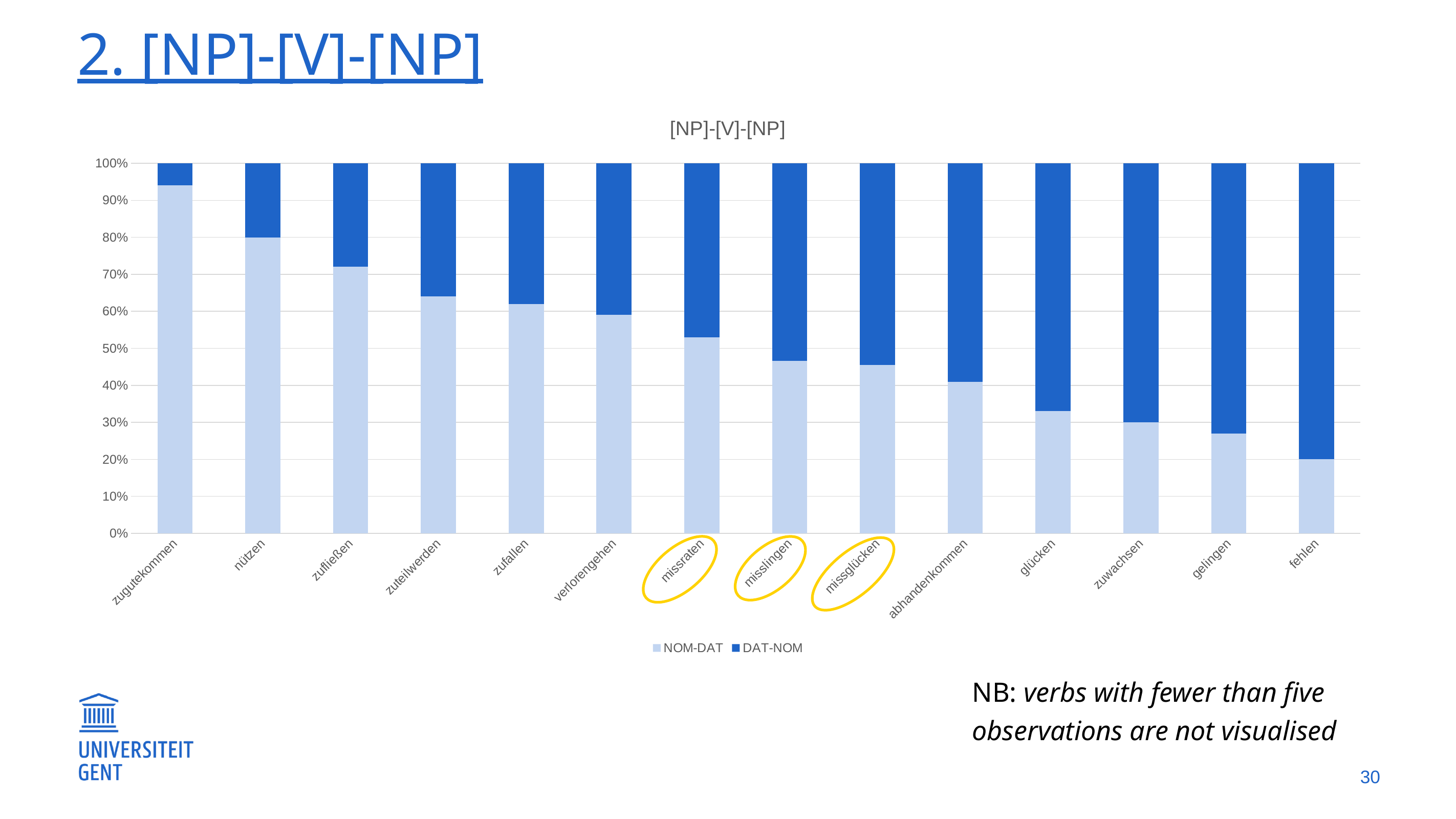
Is the NOM-DAT share for zufließen greater or less than 70%? greater Which verb has the lowest NOM-DAT share? fehlen Which verb has a larger NOM-DAT share, zuteilwerden or abhandenkommen? zuteilwerden How many verbs are shown along the x axis of the chart? 14 What kind of chart is shown on the slide? Stacked bar chart Which three verbs are circled in yellow on the x axis? missraten, misslingen, missglücken What is the NOM-DAT share for nützen? 80% Which verb has the highest NOM-DAT share? zugutekommen How many series does the legend list? 2 What is the NOM-DAT share for fehlen? 20% Is the NOM-DAT share for glücken greater or less than 40%? less Does the NOM-DAT share rise or fall moving from left to right along the x axis? fall